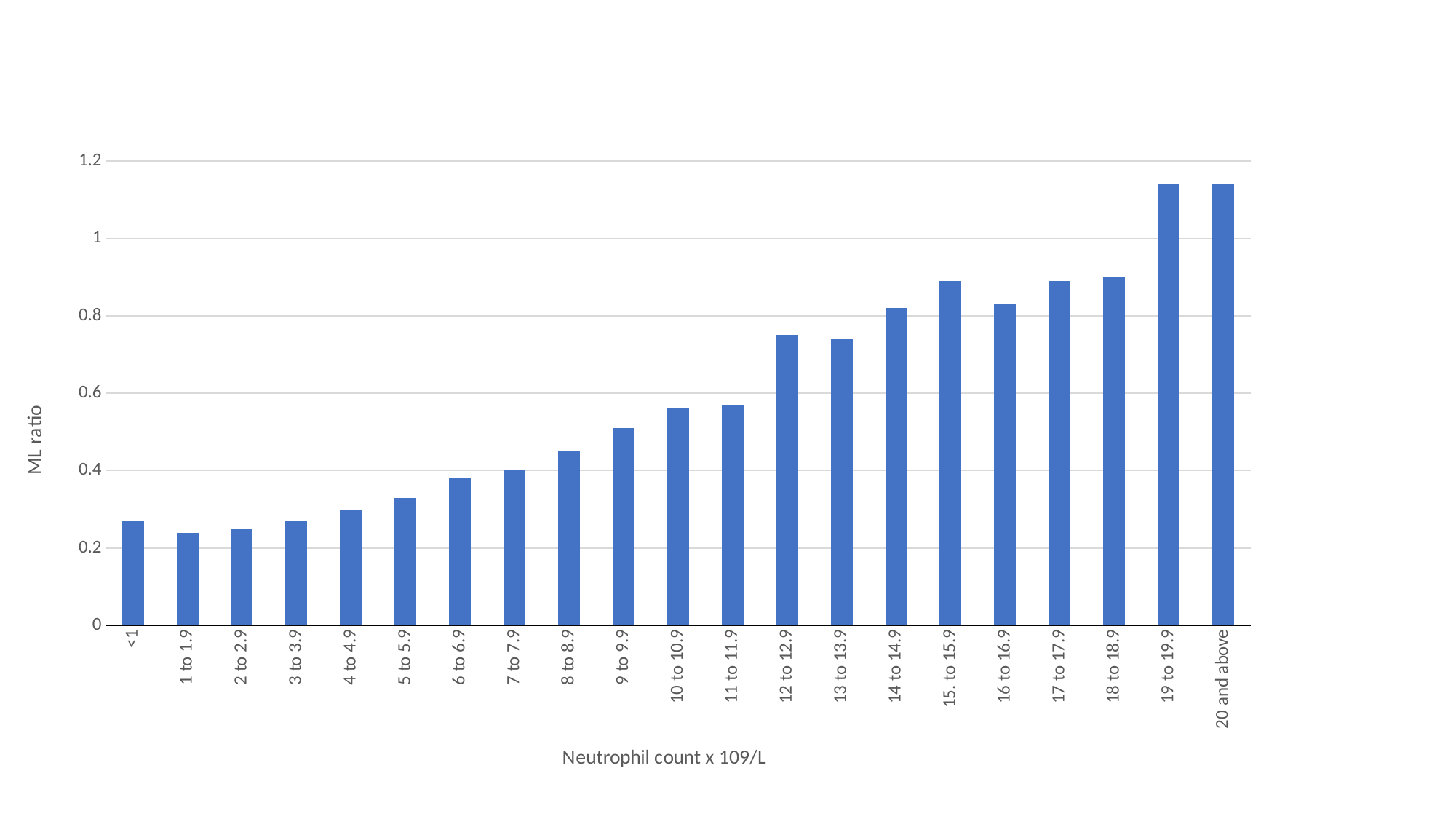
Is the ML ratio for "12 to 12.9" greater or less than 0.6? greater How many neutrophil count categories are plotted on the x axis? 21 Is the ML ratio for the "<1" category greater or less than 0.4? less Is the ML ratio for "19 to 19.9" greater or less than 1? greater What kind of chart is shown on the slide? bar chart Which has the larger ML ratio, "3 to 3.9" or "10 to 10.9"? 10 to 10.9 What is the label on the vertical axis of the chart? ML ratio Do the ML ratio values generally rise or fall as the neutrophil count increases along the x axis? rise Which has the larger ML ratio, "6 to 6.9" or "12 to 12.9"? 12 to 12.9